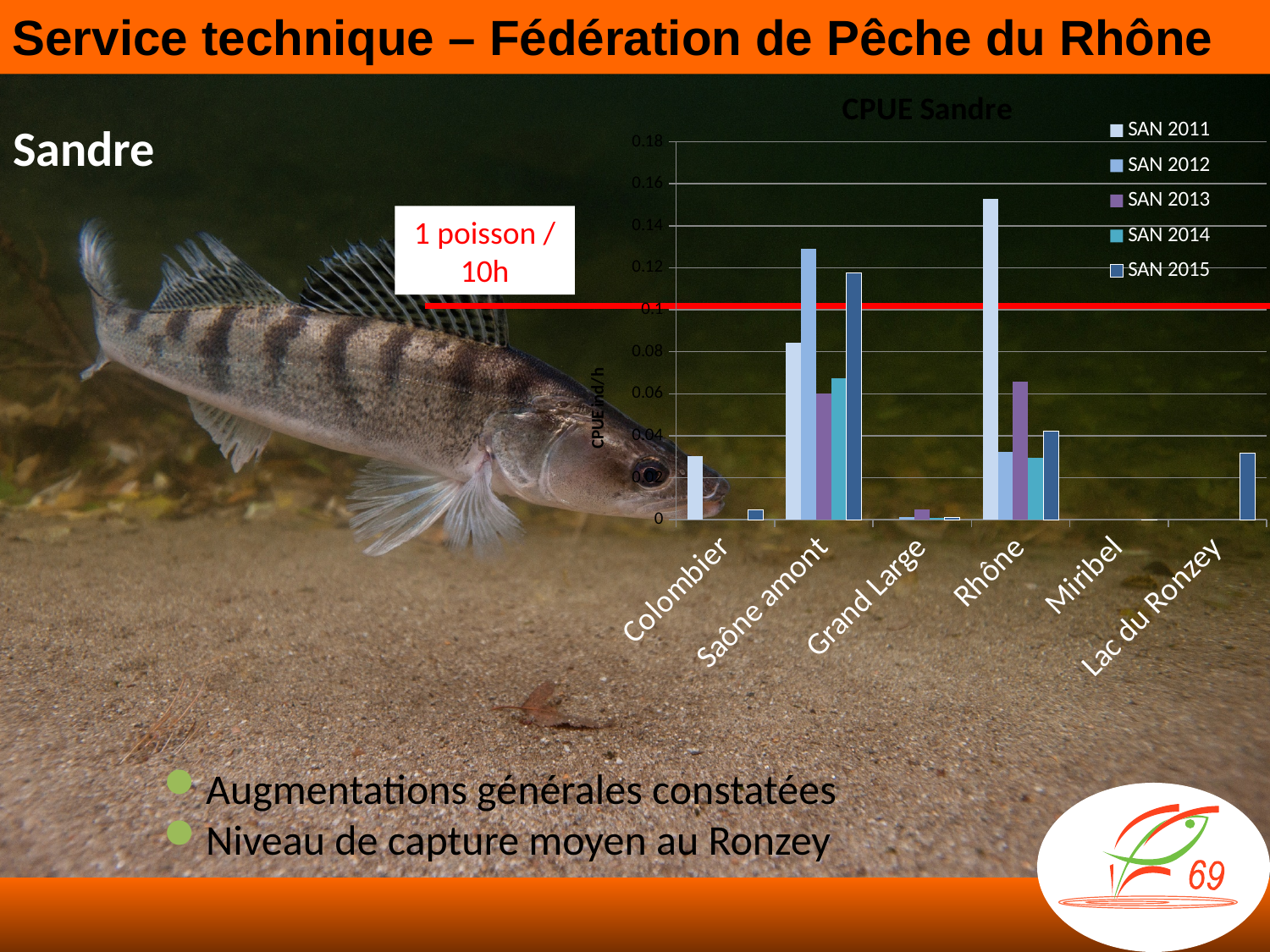
What is the title of the chart? CPUE Sandre How many categories are shown on the x axis of the chart? 6 What label is written in the box next to the red horizontal line on the chart? 1 poisson / 10h What type of chart is shown on the slide? bar chart Is the SAN 2011 value for Rhône greater or less than 0.14? greater How many series does the chart legend list? 5 Which is larger: the SAN 2015 value for Saône amont or the SAN 2015 value for Rhône? Saône amont Which category has the highest SAN 2012 value? Saône amont Is the SAN 2015 value for Saône amont greater or less than 0.1? greater Which category has the tallest bar in the chart? Rhône Is the SAN 2013 value for Rhône greater or less than 0.08? less